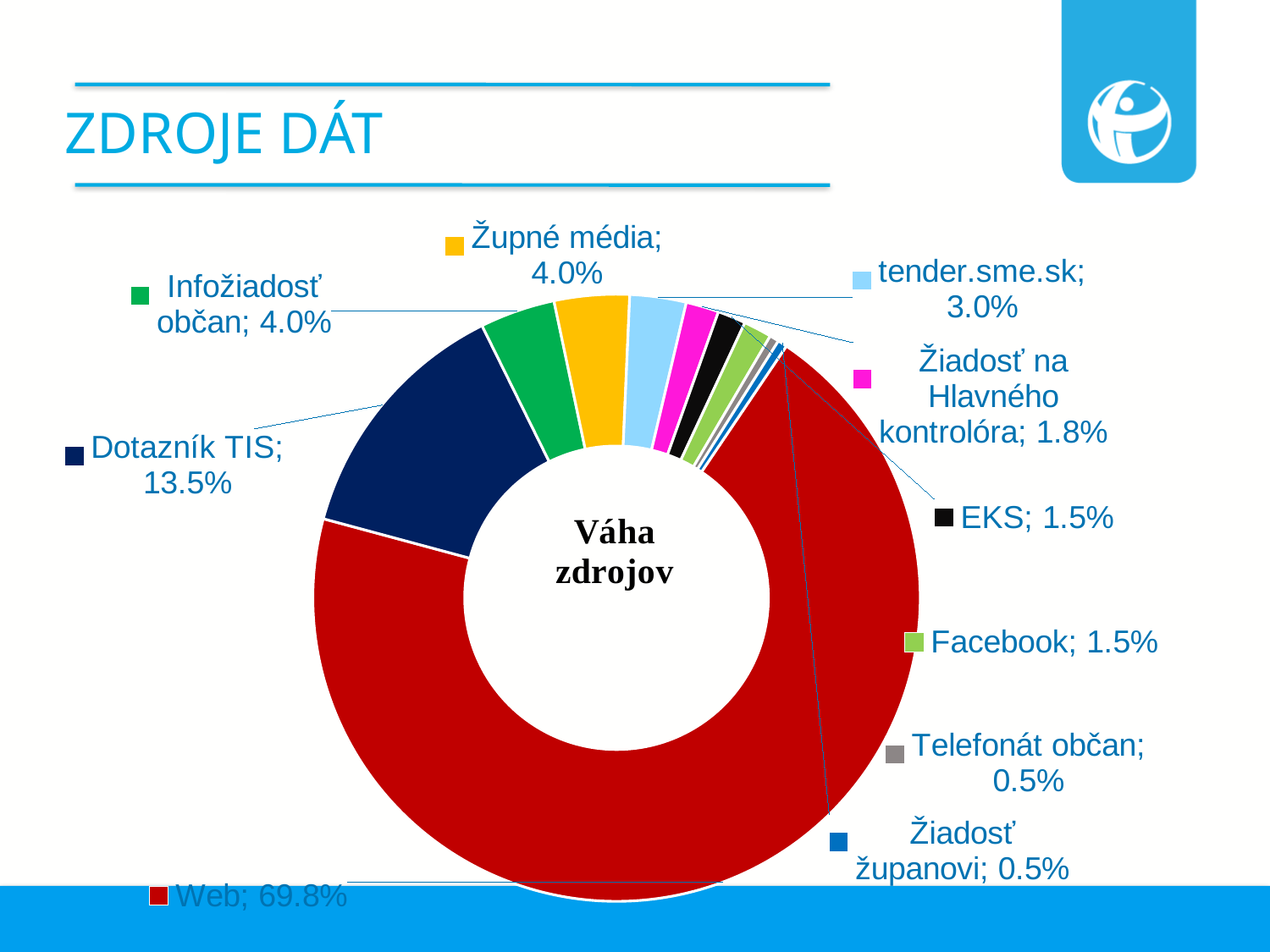
What percentage is shown for tender.sme.sk? 3.0% Which category has the smallest share: Telefonát občan, EKS or Dotazník TIS? Telefonát občan What kind of chart is shown on the slide? Doughnut (pie) chart Which category has the largest share of the chart? Web How many categories are shown in the chart? 10 What colour is the Web segment of the chart? Red What is the title written in the centre of the chart? Váha zdrojov What is the value shown for Dotazník TIS? 13.5% What share of the chart does Web account for? 69.8% What is the value for Žiadosť na Hlavného kontrolóra? 1.8% What is the difference in percentage points between Web and Dotazník TIS? 56.3 Which is larger, the share for tender.sme.sk or the share for EKS? tender.sme.sk